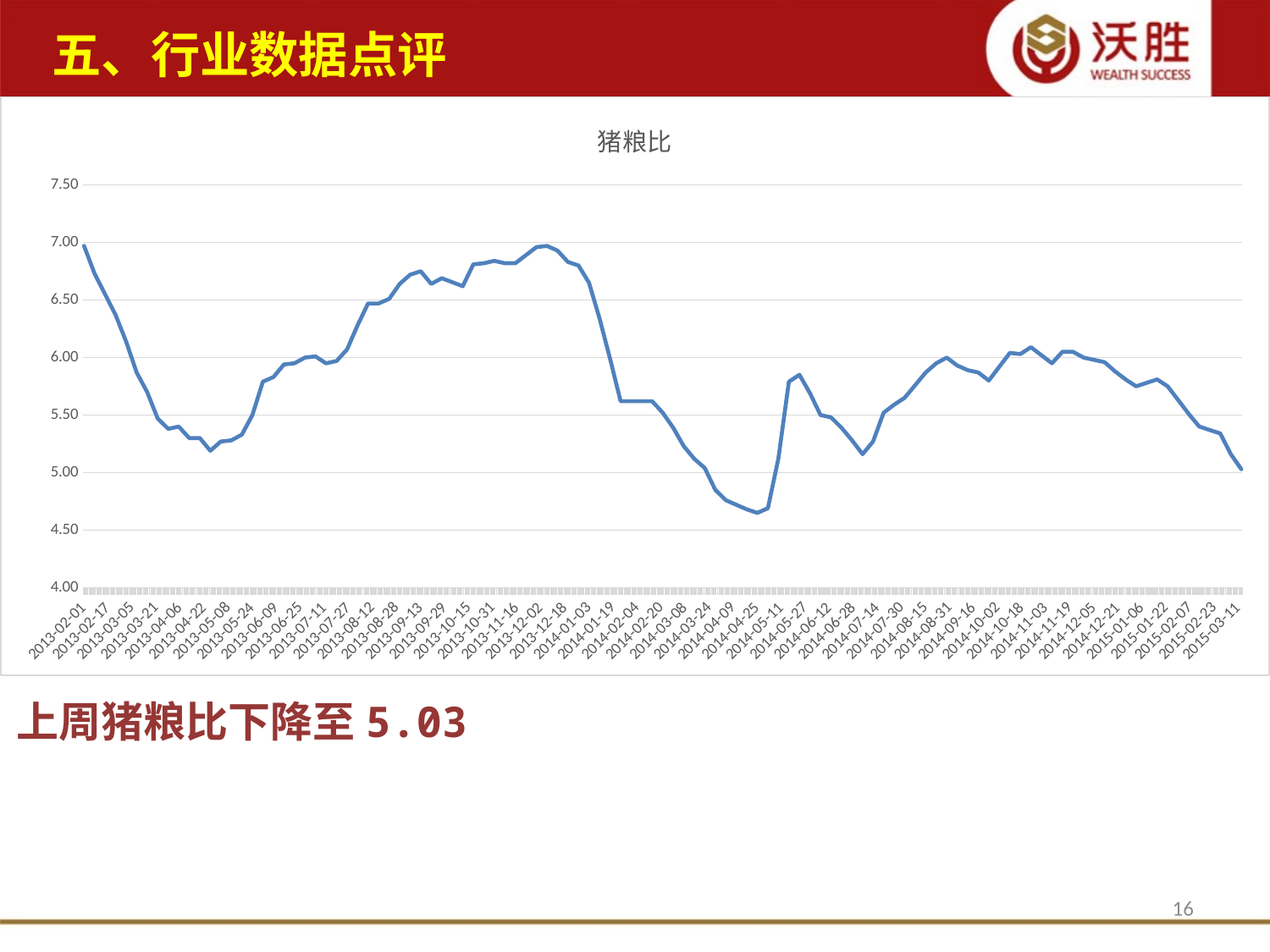
Is the value for 2014-01-19 greater or less than 6.00? less Around which date does the line reach its lowest value? 2014-04-25 Is the value for 2013-12-02 greater or less than 6.50? greater Is the value for 2015-03-11 greater or less than 5.50? less Does the line rise or fall between 2014-04-25 and 2014-05-27? rise What value does the chart's final point (2015-03-11) show, as stated on the slide? 5.03 Does the line rise or fall between 2013-02-01 and 2013-04-22? fall Which is larger, the value for 2013-02-01 or the value for 2014-04-25? 2013-02-01 What kind of chart is shown on the slide? line chart What is the title of the chart? 猪粮比